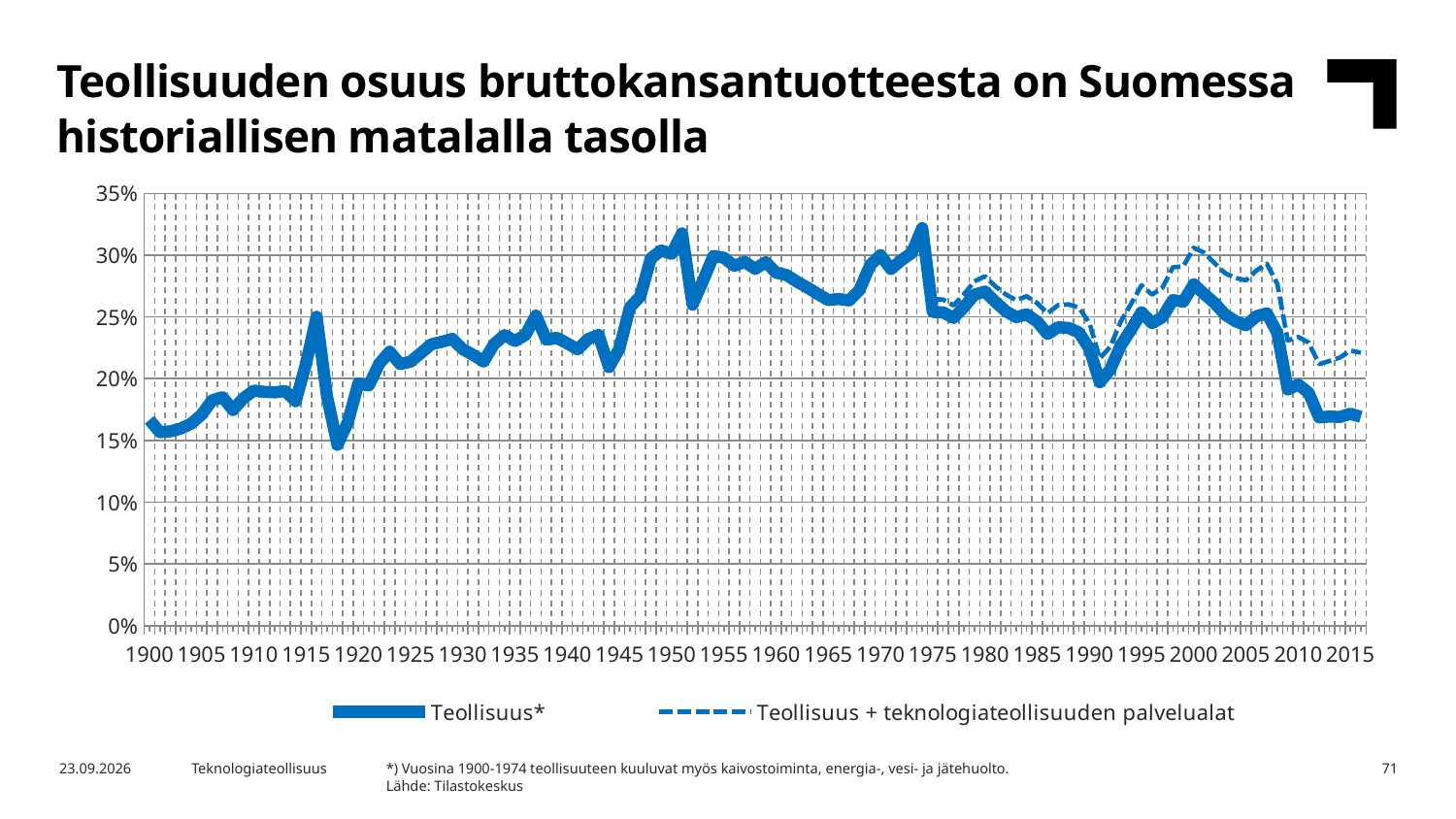
Is the highest point of the Teollisuus* line greater or less than 30%? greater Is the value for Teollisuus* in 2015 greater or less than 20%? less Does the Teollisuus* line rise or fall between 2005 and 2015? fall What are the two series named in the legend? Teollisuus* and Teollisuus + teknologiateollisuuden palvelualat Does the Teollisuus* line overall rise or fall between 1900 and 1950? rise What kind of chart is shown on the slide? line chart In 2000, which series has the higher value: Teollisuus* or Teollisuus + teknologiateollisuuden palvelualat? Teollisuus + teknologiateollisuuden palvelualat What is the title of the slide containing the chart? Teollisuuden osuus bruttokansantuotteesta on Suomessa historiallisen matalalla tasolla Is the value for Teollisuus* in 1900 greater or less than 20%? less How many series does the legend list? 2